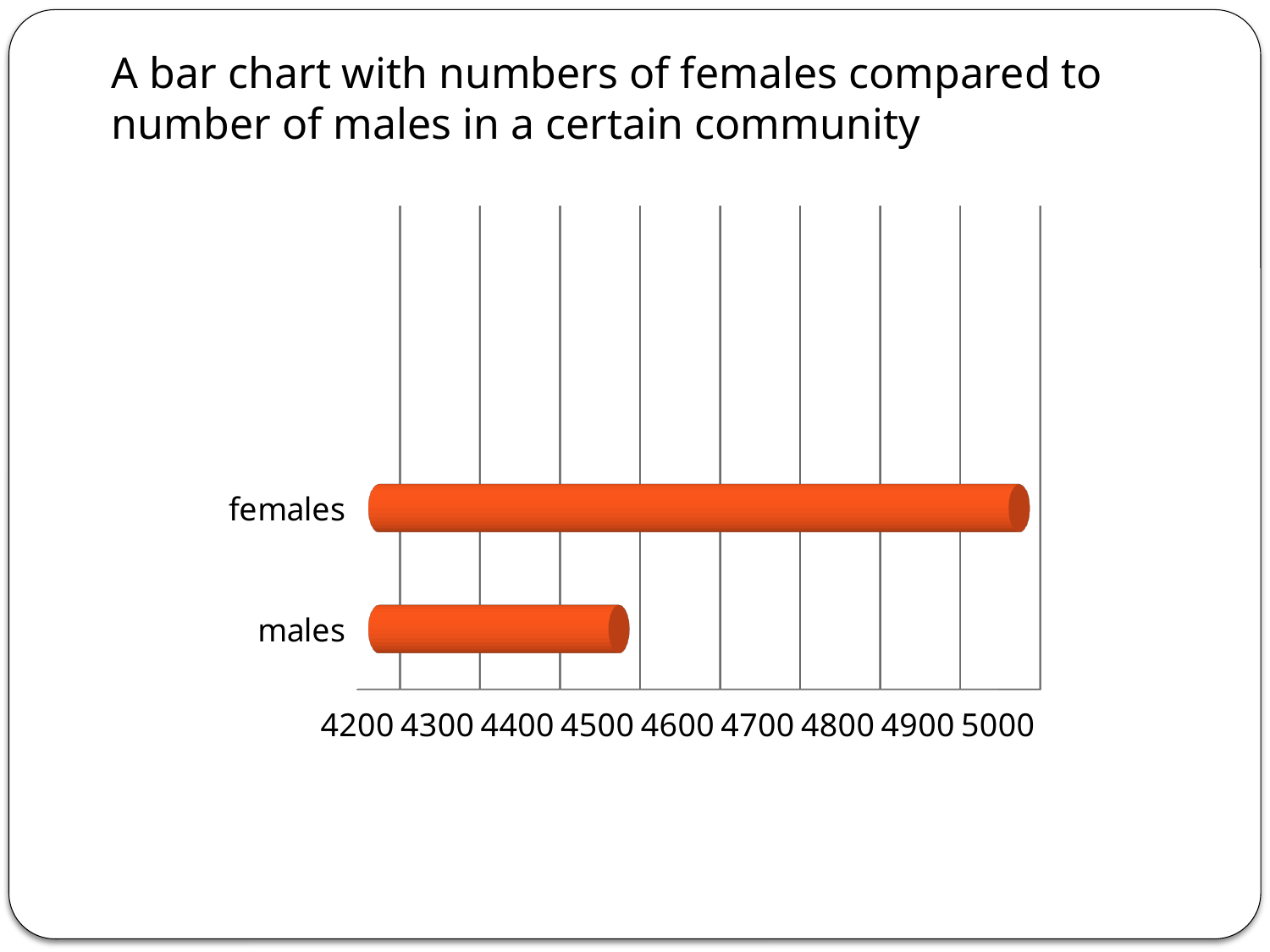
Is the value for males greater or less than 4400? greater Is the value for males greater or less than 4600? less What is the lowest value shown on the horizontal axis of the chart? 4200 How many categories are plotted in the chart? 2 What is the highest value shown on the horizontal axis of the chart? 5000 What kind of chart is shown on the slide? bar chart Which is larger, the value for females or the value for males? females Is the value for females greater or less than 4900? greater Which category has the lowest value in the chart? males Which category has the highest value in the chart? females